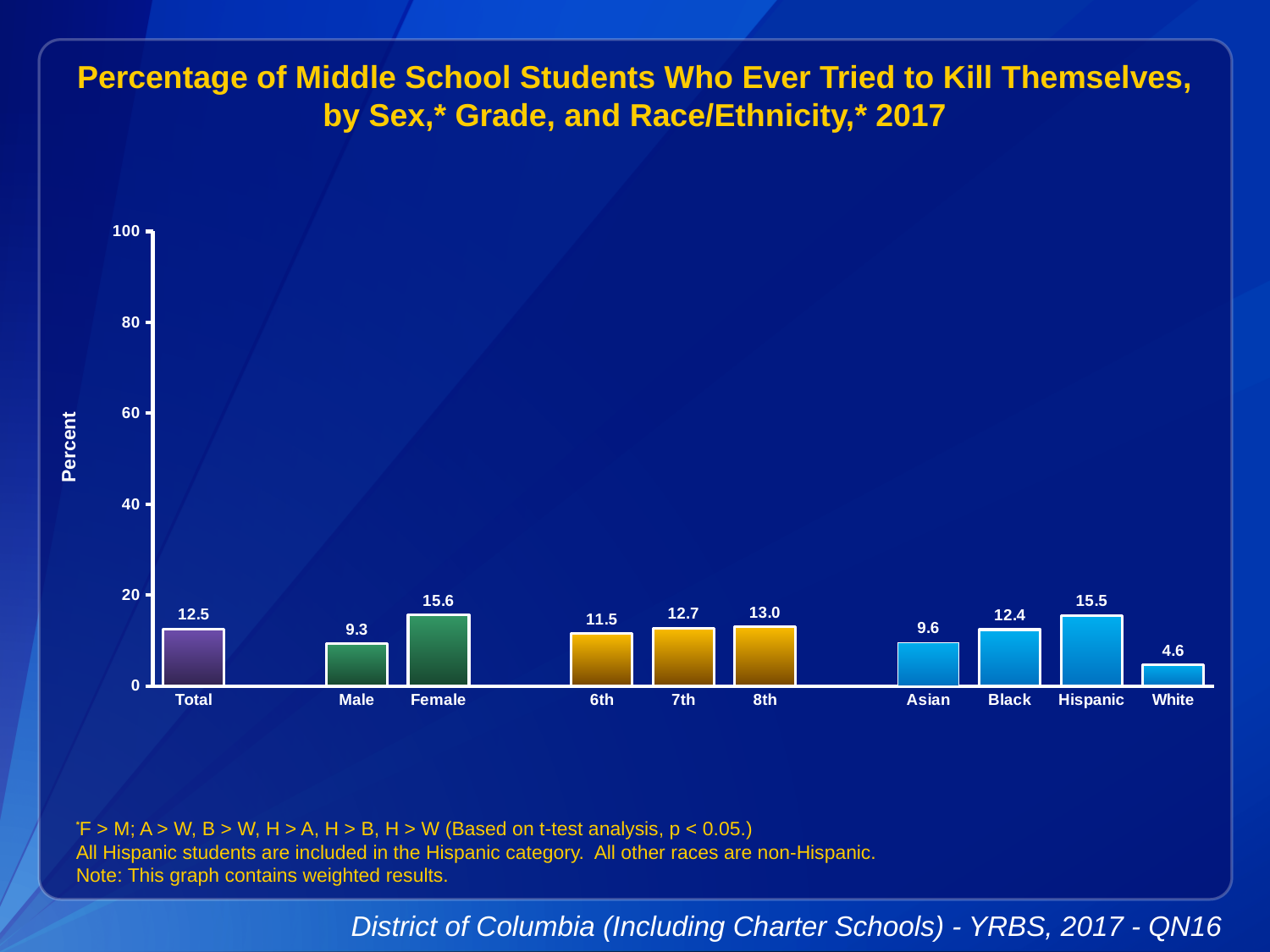
What is the value for Total? 12.5 Is the value for 8th greater or less than 20? less What is the value for Female? 15.6 Do the values rise or fall from 6th to 8th grade? rise What is the label on the y axis? Percent Which category has the highest value? Female What is the value for Asian? 9.6 What is the difference between the values for Female and Male? 6.3 Which is larger, the value for Hispanic or the value for Black? Hispanic What kind of chart is shown? bar chart Which category has the lowest value? White How many categories are shown on the x axis? 10